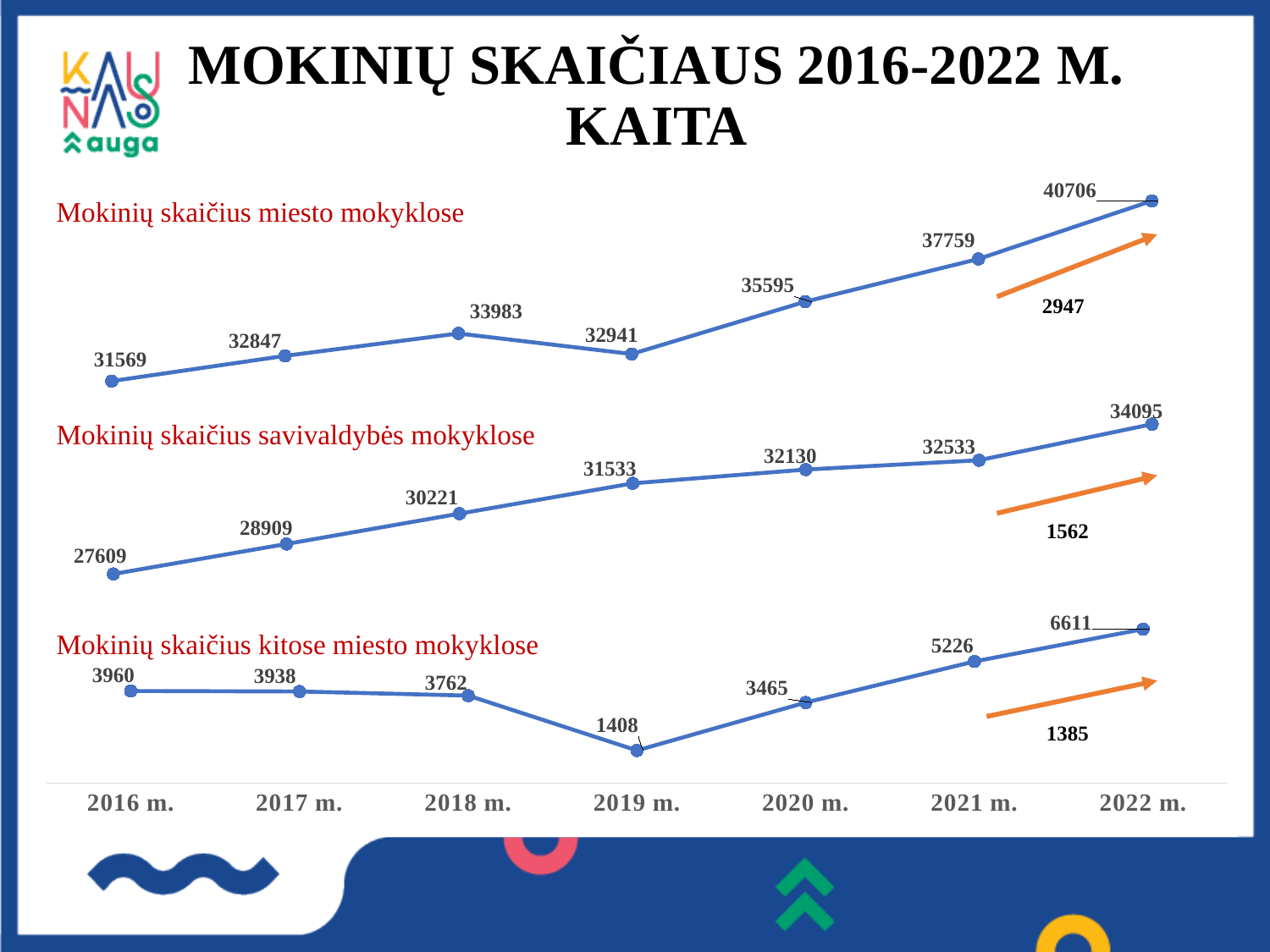
What is the difference between the 2022 m. and 2021 m. values for 'Mokinių skaičius kitose miesto mokyklose'? 1385 What is the value for 'Mokinių skaičius miesto mokyklose' in 2022 m.? 40706 How many years are shown on the x axis? 7 In which year is 'Mokinių skaičius miesto mokyklose' highest? 2022 m. What is the value for 'Mokinių skaičius savivaldybės mokyklose' in 2016 m.? 27609 In which year is 'Mokinių skaičius kitose miesto mokyklose' lowest? 2019 m. Does 'Mokinių skaičius savivaldybės mokyklose' rise or fall from 2016 m. to 2022 m.? rise What kind of chart is shown on the slide? line chart Which is larger for 'Mokinių skaičius miesto mokyklose': the 2018 m. value or the 2019 m. value? 2018 m. What is the difference between the 2022 m. and 2021 m. values for 'Mokinių skaičius miesto mokyklose'? 2947 How many data series are plotted on the chart? 3 What is the value for 'Mokinių skaičius kitose miesto mokyklose' in 2019 m.? 1408